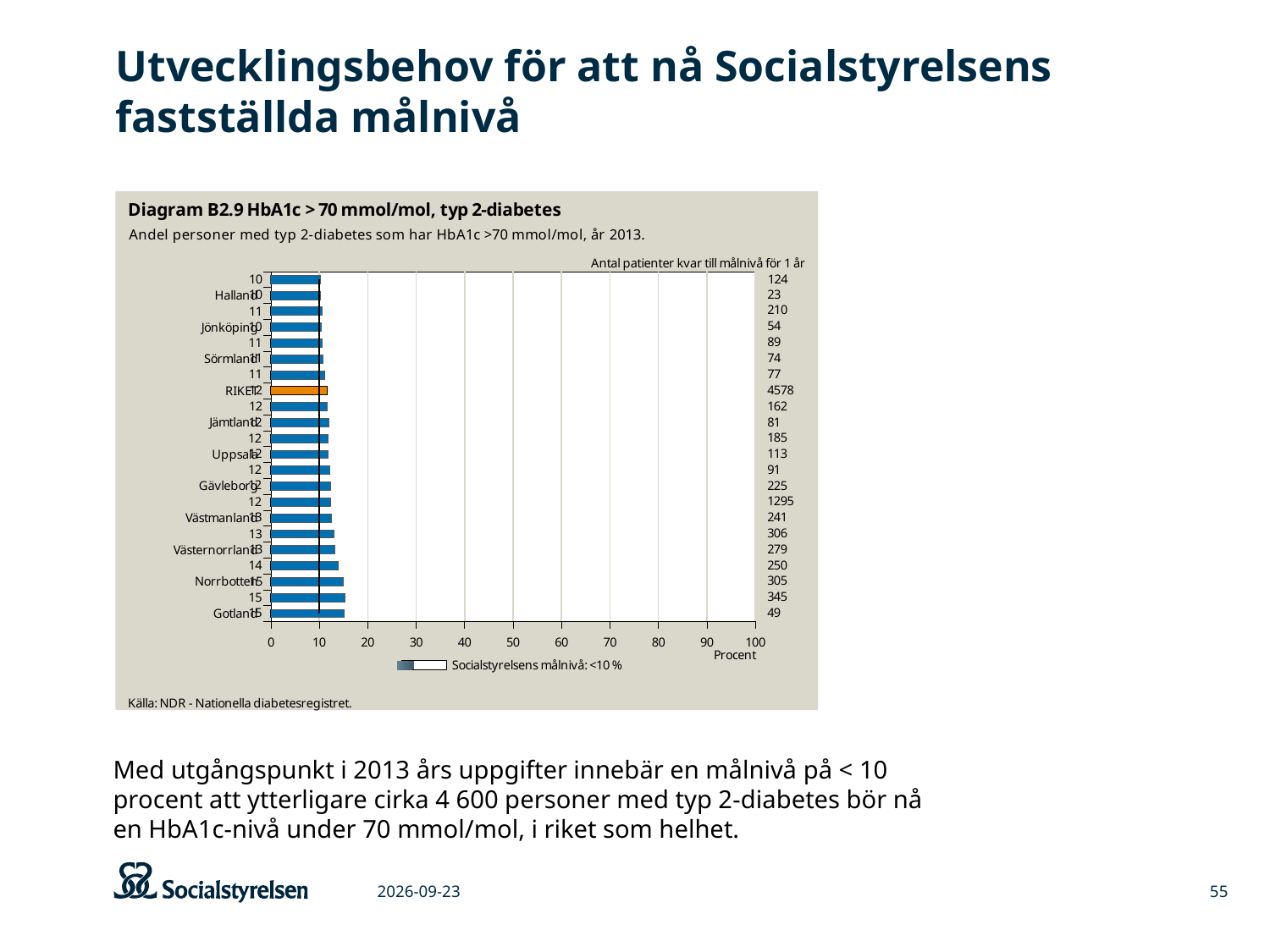
What target level does the legend state (Socialstyrelsens målnivå)? <10 % How many bars are plotted in the chart? 22 How many patients remain to reach the target level (Antal patienter kvar till målnivå för 1 år) for RIKET? 4578 Which has the larger percentage value, Gotland or Halland? Gotland Is the value for RIKET greater or less than 20 percent? less What is the percentage value shown for RIKET? 12 What is the percentage value shown for Norrbotten? 15 What is the percentage value shown for Halland? 10 What type of chart is shown on the slide? bar chart What is the percentage value shown for Gotland? 15 What is the difference between the percentage values for Gotland and Halland? 5 What is the title of the diagram? Diagram B2.9 HbA1c > 70 mmol/mol, typ 2-diabetes